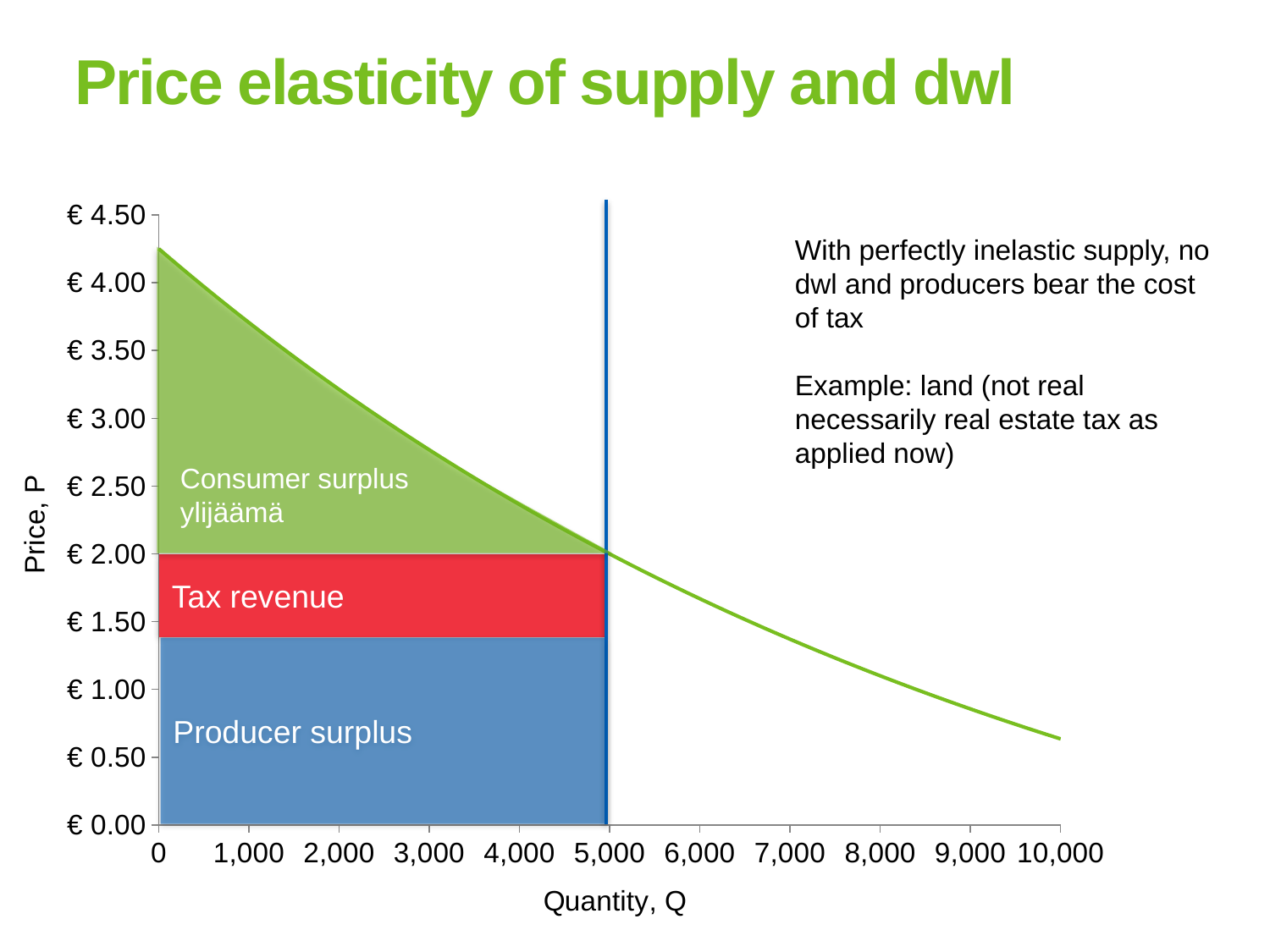
Which shaded region is coloured red? Tax revenue How many shaded regions are labelled in the chart? 3 Does the green demand curve rise or fall as quantity increases? fall What kind of chart is shown on the slide? line chart What is the label of the vertical axis? Price, P Is the price on the demand curve at a quantity of 3,000 greater or less than € 2.50? greater At what quantity is the vertical blue supply line drawn? 5,000 What is the label of the horizontal axis? Quantity, Q At what price does the green demand curve cross the vertical blue supply line? € 2.00 Is the price on the demand curve at a quantity of 0 greater or less than € 4.00? greater Is the price on the demand curve at a quantity of 10,000 greater or less than € 1.00? less